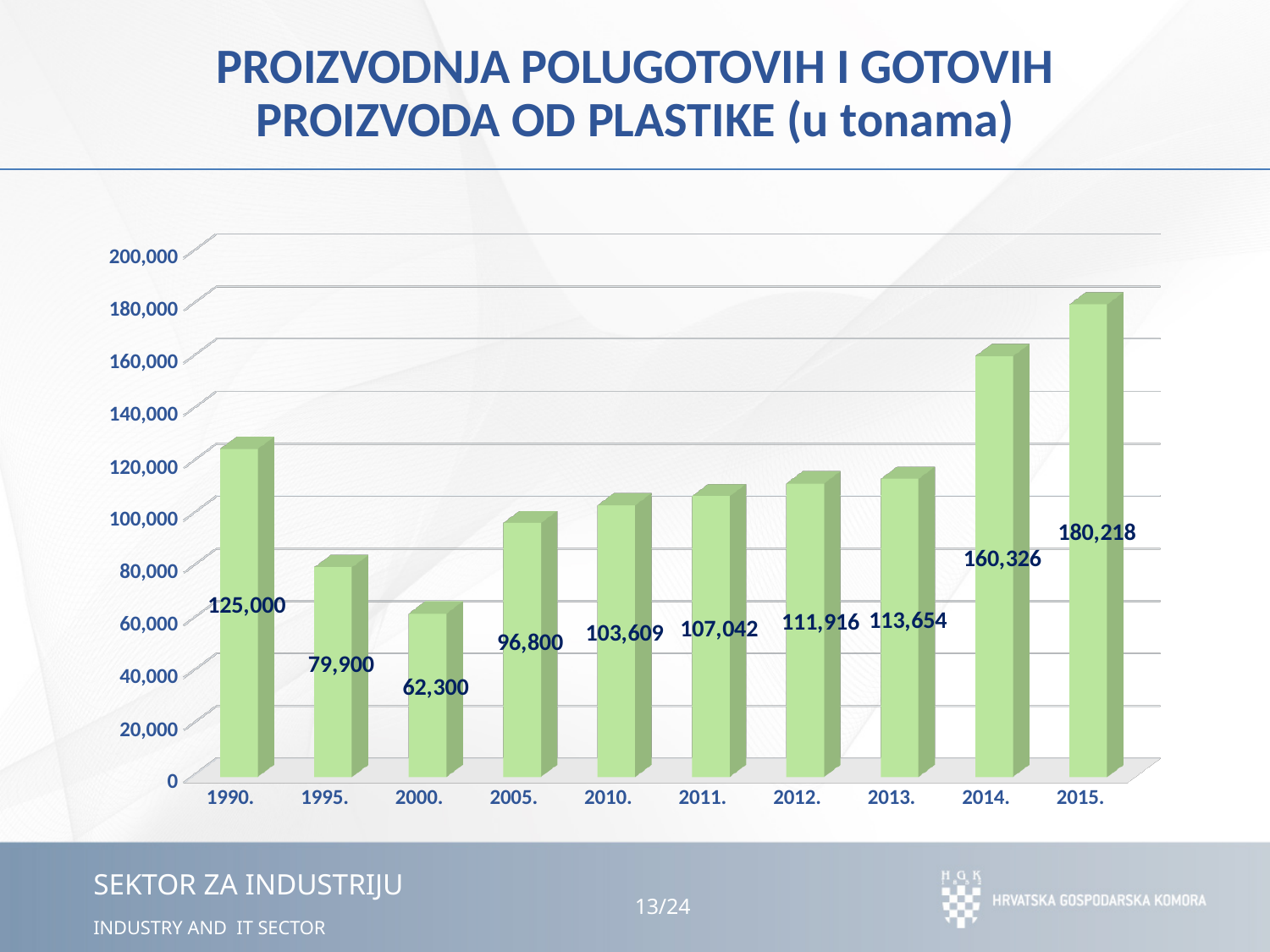
What is the difference between the values for 2015 and 2014? 19,892 What kind of chart is shown on the slide? bar chart What value is shown for 2012? 111,916 Which is larger, the value for 1990 or the value for 2013? 1990. Is the value for 2005 greater or less than 100,000? less Which year has the highest production? 2015. Do the values rise or fall from 2000 to 2015? rise How many years are shown on the x axis? 10 Which year has the lowest production? 2000. What value is shown for 1990? 125,000 What was the production of plastic products in 2015? 180,218 What is the difference between the values for 1990 and 2000? 62,700